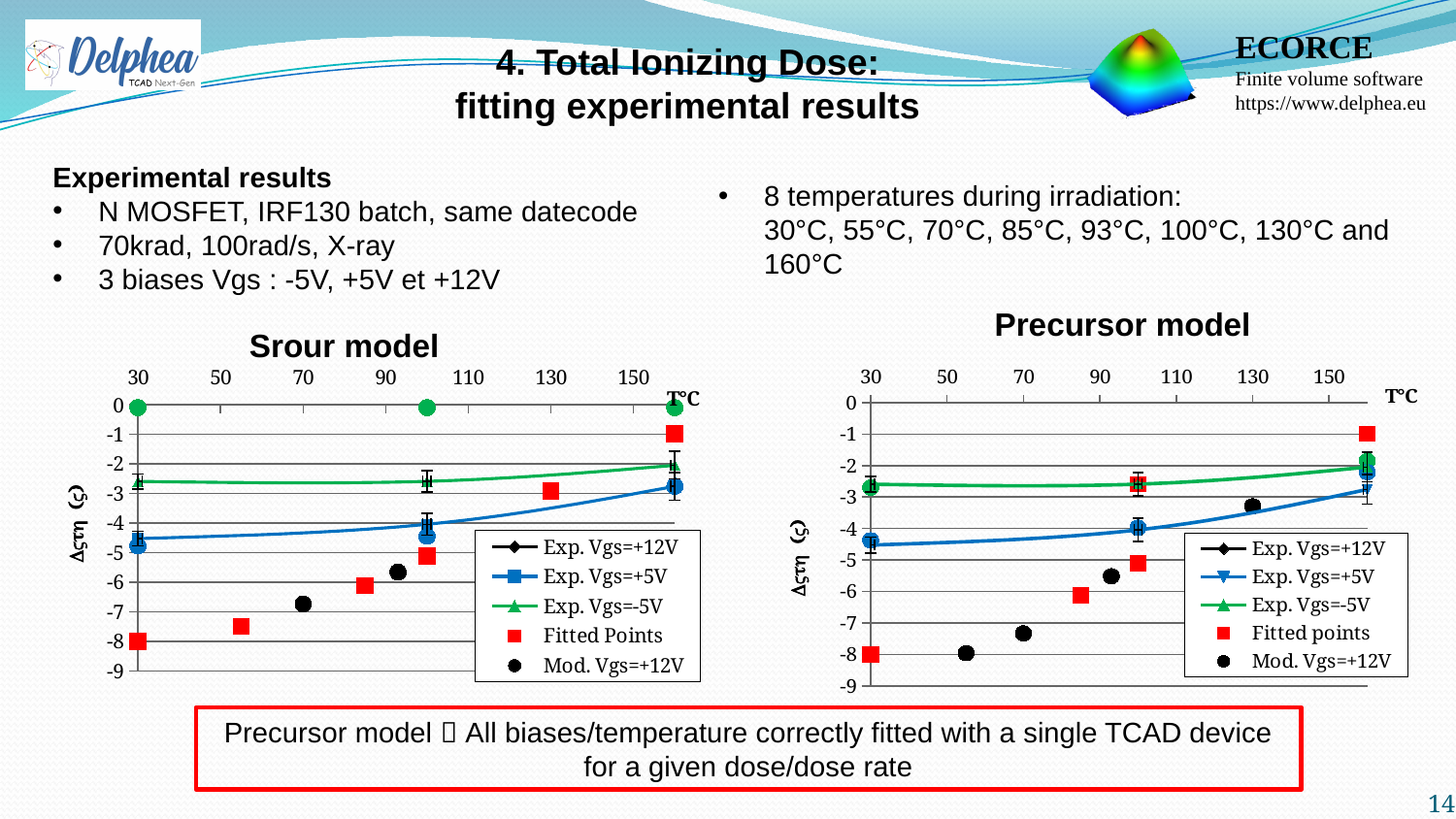
In the Precursor model chart, do the Exp. Vgs=+5V values rise or fall as temperature increases? rise In the Precursor model chart, at 100°C, which is larger: the Exp. Vgs=-5V value or the Fitted points value? Exp. Vgs=-5V In the Precursor model chart, is the Exp. Vgs=-5V value at 30°C greater or less than -4? greater In the Srour model chart, is the Fitted Points value at 30°C greater or less than -5? less In the Srour model chart, at 30°C, which is larger: the Exp. Vgs=-5V value or the Exp. Vgs=+5V value? Exp. Vgs=-5V What is the title of the chart on the left of the slide? Srour model In the Precursor model chart, is the Fitted points value at 160°C greater or less than -2? greater What kind of chart is the Precursor model chart? line chart What is the x-axis label of the Srour model chart? T°C In the Precursor model chart, how many series does the legend list? 5 In the Srour model chart, do the Mod. Vgs=+12V values rise or fall as temperature increases? rise In the Srour model chart, how many series does the legend list? 5